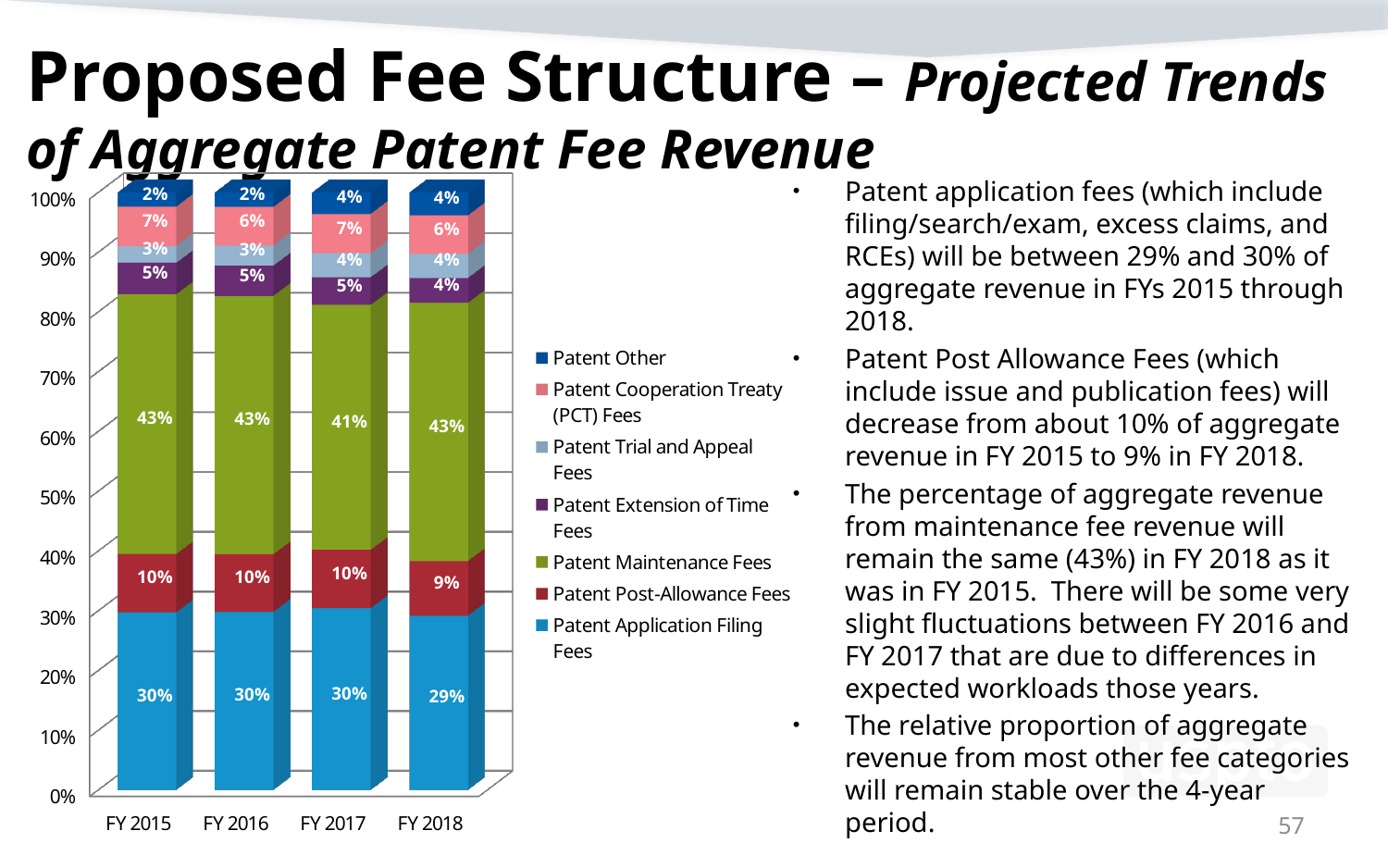
What type of chart is shown on the slide? Stacked bar chart Which fee category has the largest share of aggregate revenue in FY 2015? Patent Maintenance Fees What percentage of aggregate revenue do Patent Maintenance Fees account for in FY 2017? 41% Which fee category has the smallest share of aggregate revenue in FY 2016? Patent Other What is the value for Patent Cooperation Treaty (PCT) Fees in FY 2016? 6% What is the value for Patent Application Filing Fees in FY 2018? 29% Which is larger in FY 2018: Patent Post-Allowance Fees or Patent Cooperation Treaty (PCT) Fees? Patent Post-Allowance Fees What is the value for Patent Extension of Time Fees in FY 2018? 4% What is the difference between the Patent Maintenance Fees share in FY 2016 and in FY 2017? 2% How many fiscal years are shown on the x axis of the chart? 4 What is the value for Patent Other in FY 2015? 2% How many series does the chart legend list? 7